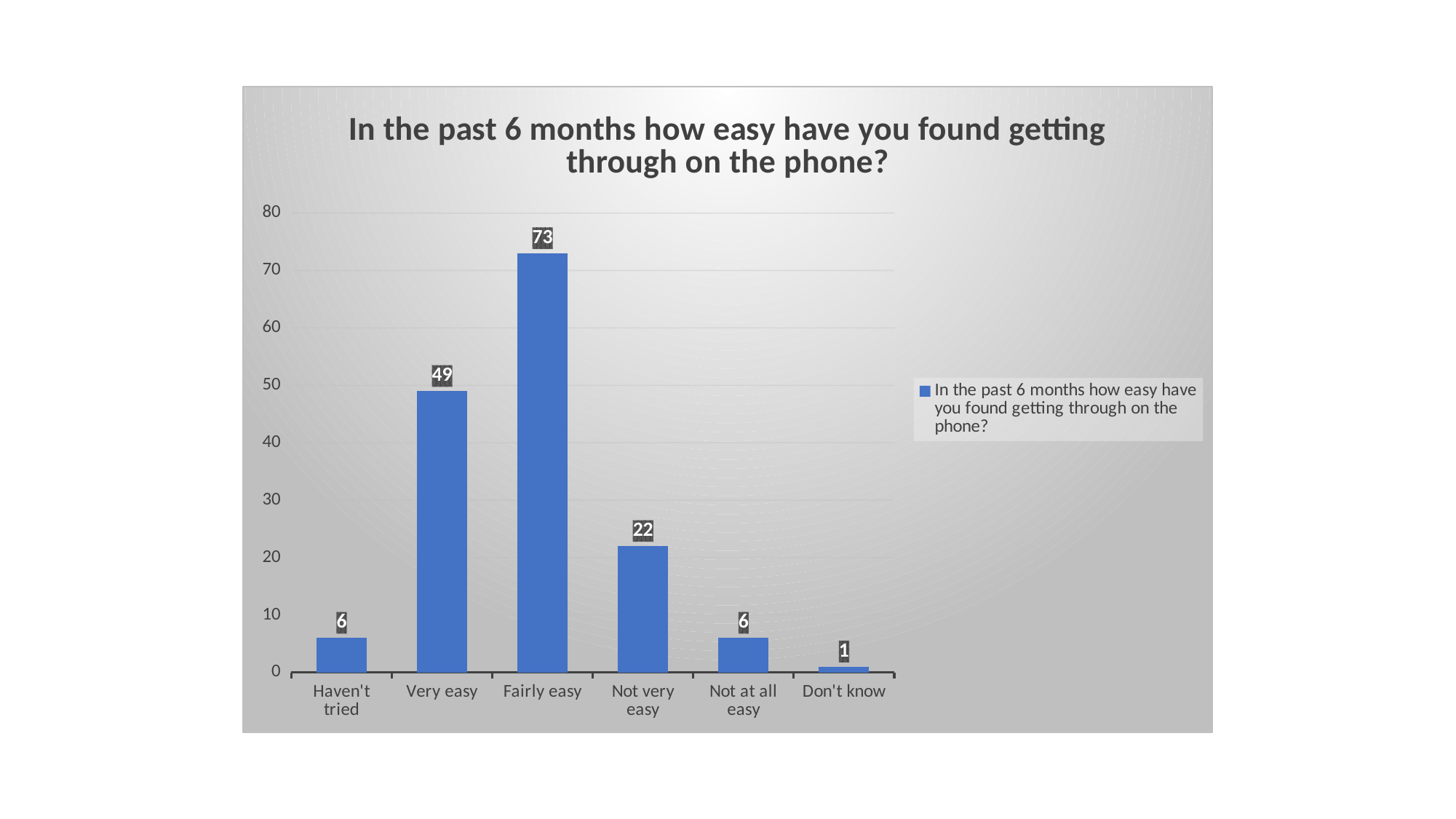
What is the value for Very easy? 49 Is the value for Not very easy greater or less than 30? less What is the difference between the values for Fairly easy and Very easy? 24 Which category has the lowest value? Don't know Which is larger, the value for Very easy or the value for Not very easy? Very easy What is the title of the chart? In the past 6 months how easy have you found getting through on the phone? Which category has the highest value? Fairly easy What is the value for Fairly easy? 73 What is the value for Not very easy? 22 What kind of chart is shown on the slide? Bar chart What is the value for Don't know? 1 How many categories are shown on the x axis? 6